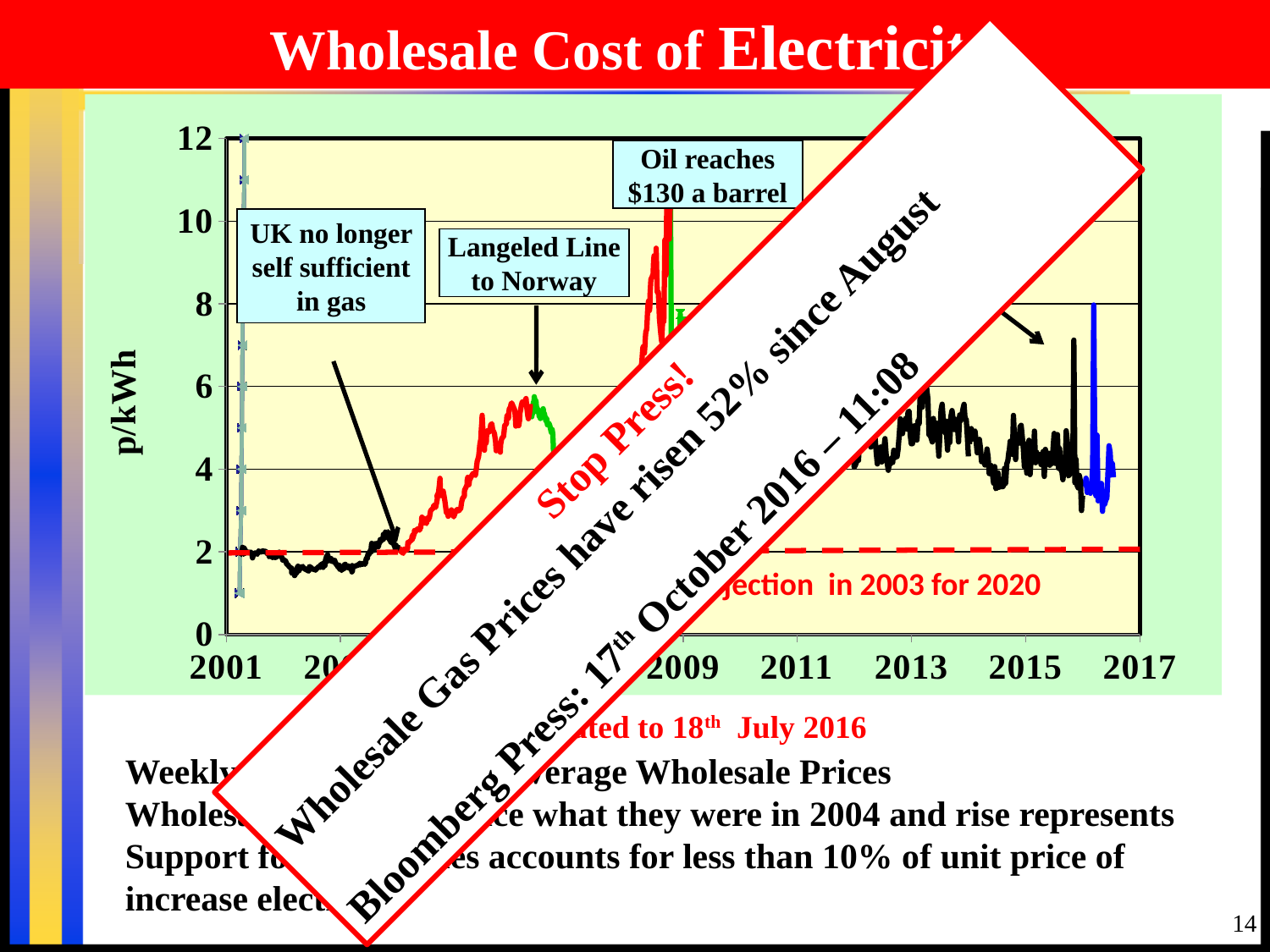
Is the peak value of the red line around 2008 greater or less than the dashed red projection line value of 2? greater What is the highest value shown on the vertical axis of the chart? 12 At what value on the vertical axis does the dashed red projection line sit? 2 Does the plotted price rise or fall between 2001 and its peak around 2008? rise What is the label on the vertical axis of the chart? p/kWh What is the last year labelled on the horizontal axis? 2017 What kind of chart is shown on the slide? line chart Is the lowest point of the black line in the early years (before the rise) greater or less than 2 p/kWh? less Is the value of the black line around 2013 greater or less than 4 p/kWh? greater What is the first year labelled on the horizontal axis? 2001 Is the peak value of the red line around 2008 greater or less than 8 p/kWh? greater